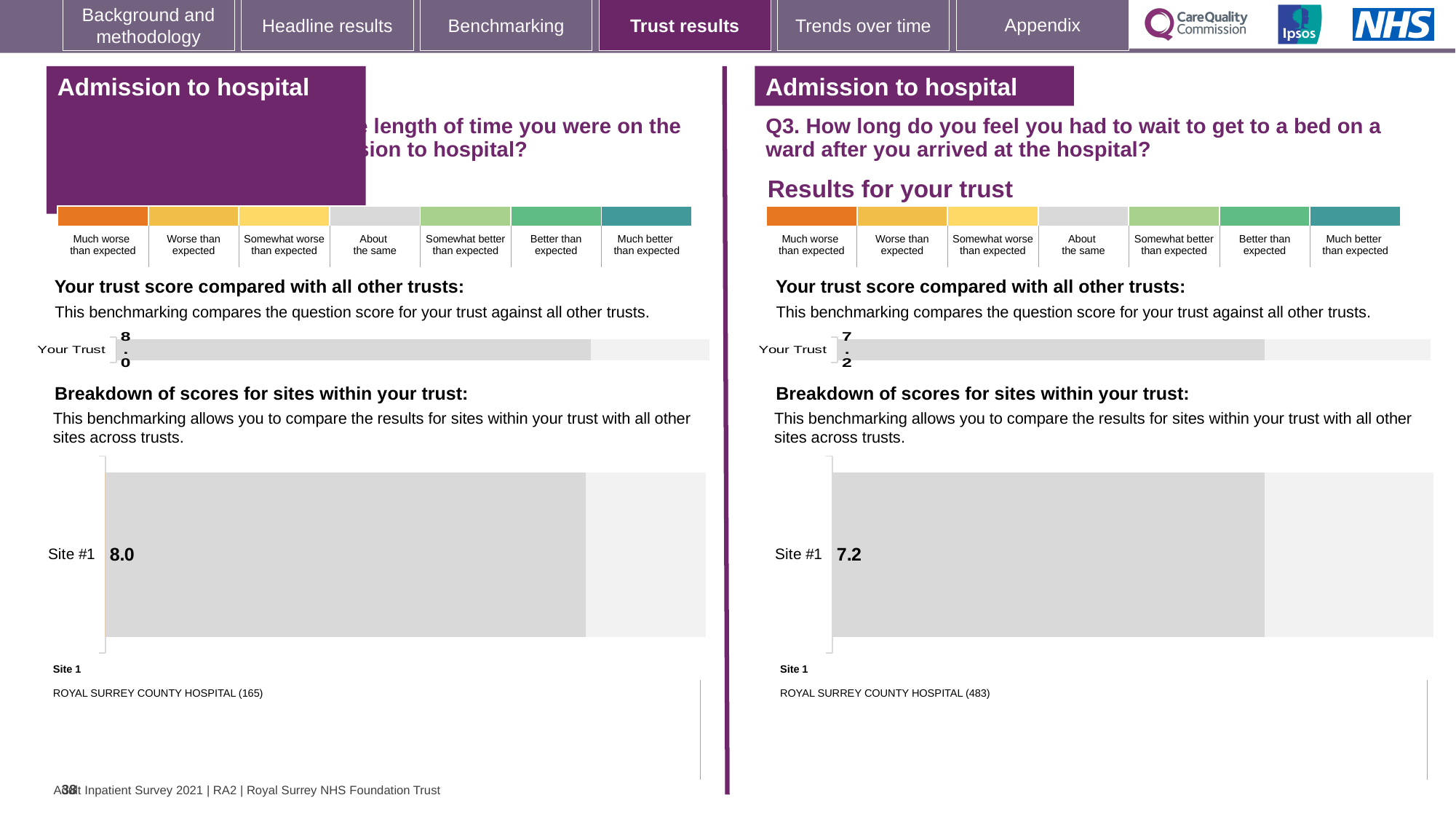
How many sites are shown in the 'Breakdown of scores for sites within your trust' chart on the right panel? 1 On the right panel, what is the score shown for Your Trust in the 'Your trust score compared with all other trusts' chart? 7.2 What is the difference between the Site #1 score on the left panel and the Site #1 score on the right panel? 0.8 On the right panel, what score is shown for Site #1 in the 'Breakdown of scores for sites within your trust' chart? 7.2 Is the Site #1 score on the left panel the same as the Your Trust score on the left panel? Yes, both are 8.0 How many sites are shown in the 'Breakdown of scores for sites within your trust' chart on the left panel? 1 Which is larger: the Your Trust score on the left panel or the Your Trust score on the right panel? Left panel (8.0) On the left panel, what is the score shown for Your Trust in the 'Your trust score compared with all other trusts' chart? 8.0 What question is the right panel's chart about? Q3. How long do you feel you had to wait to get to a bed on a ward after you arrived at the hospital? On the left panel, what score is shown for Site #1 in the 'Breakdown of scores for sites within your trust' chart? 8.0 Which site is listed as Site 1 on the right panel, and how many respondents are shown in brackets? ROYAL SURREY COUNTY HOSPITAL (483) What type of chart is used to show the Site #1 score on the right panel? Bar chart